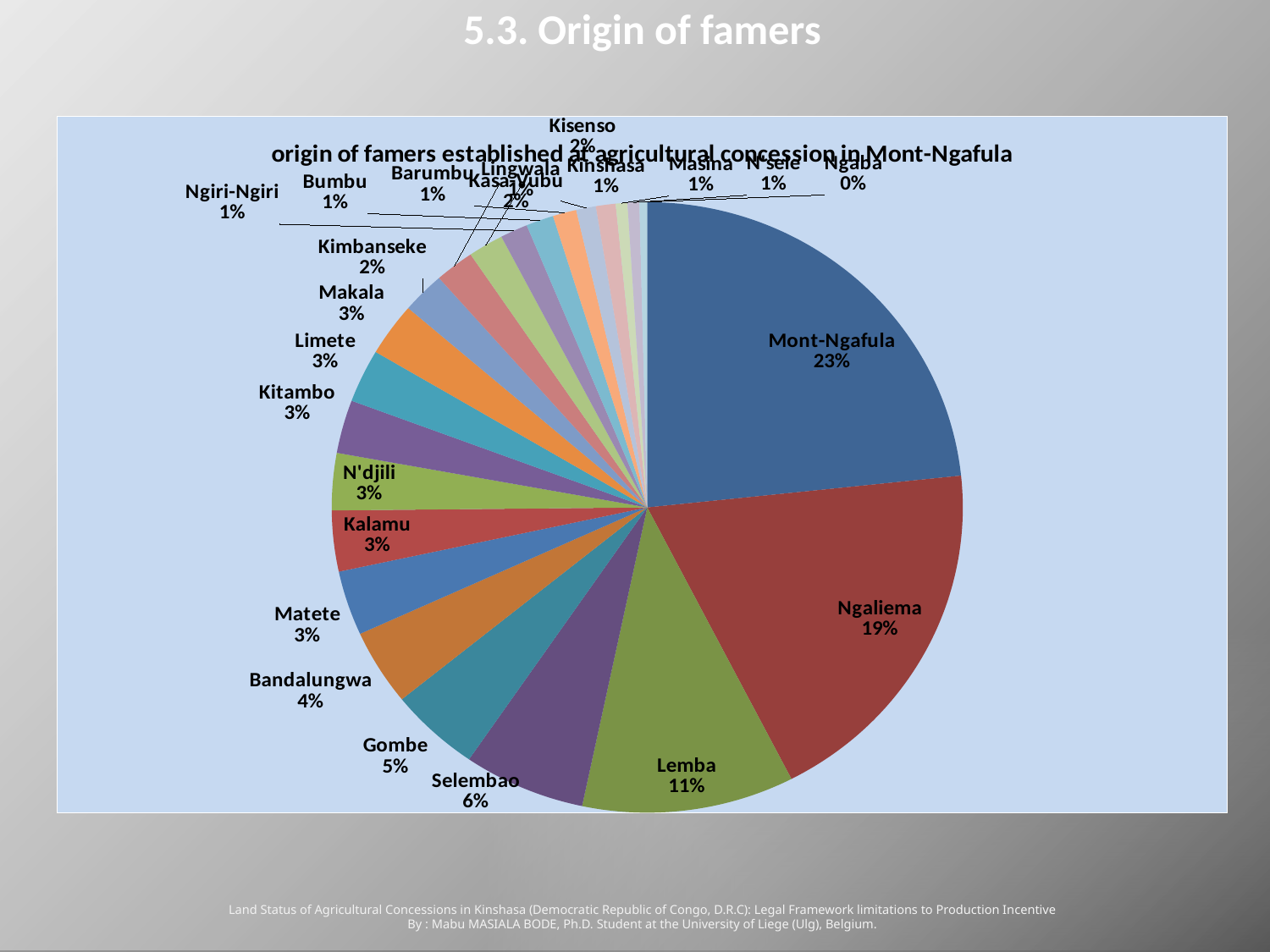
What percentage is shown for Bandalungwa? 4% Which has a larger share, Lemba or Selembao? Lemba What kind of chart is shown on the slide? Pie chart What percentage is shown for Ngaliema? 19% What is the value for Lemba? 11% What share of the pie does Mont-Ngafula represent? 23% What is the title of the chart? origin of famers established at agricultural concession in Mont-Ngafula What percentage is shown for Selembao? 6% Which origin has the largest share of the pie? Mont-Ngafula What is the value for Gombe? 5% What is the difference in percentage points between Mont-Ngafula and Ngaliema? 4 Which origin has the smallest share of the pie? Ngaba